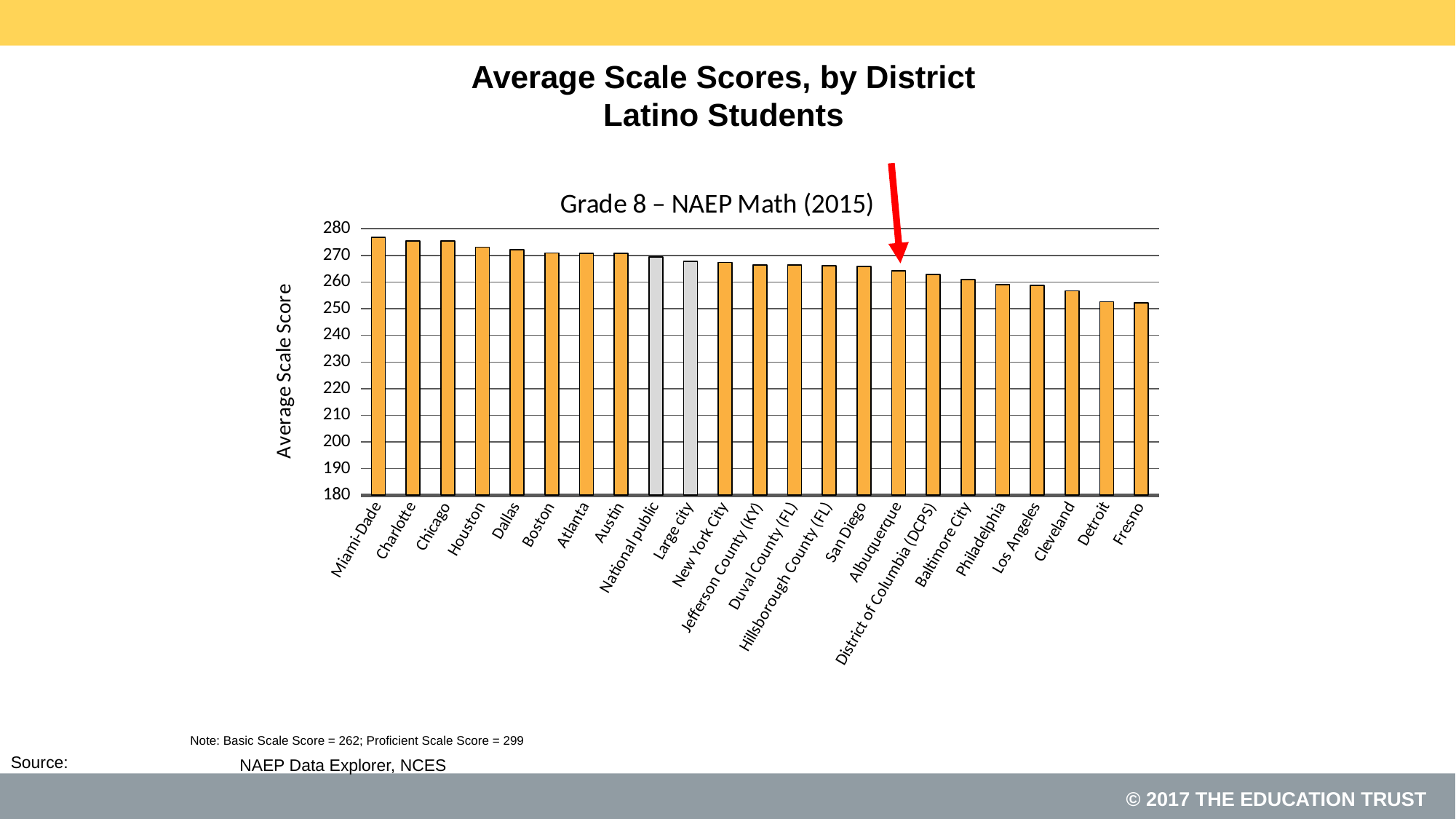
Is the value for Miami-Dade greater or less than 270? greater Which has a higher average scale score, Chicago or San Diego? Chicago Which category has the highest average scale score? Miami-Dade Is the value for Houston greater or less than 270? greater How many bars (districts and reference groups) are plotted in the chart? 23 What is the title shown above the chart's plot area? Grade 8 – NAEP Math (2015) Is the value for Fresno greater or less than 260? less Do the values generally rise or fall moving from left to right along the x axis? Fall Which two bars are shaded grey instead of orange? National public and Large city What kind of chart is shown on the slide? Bar chart